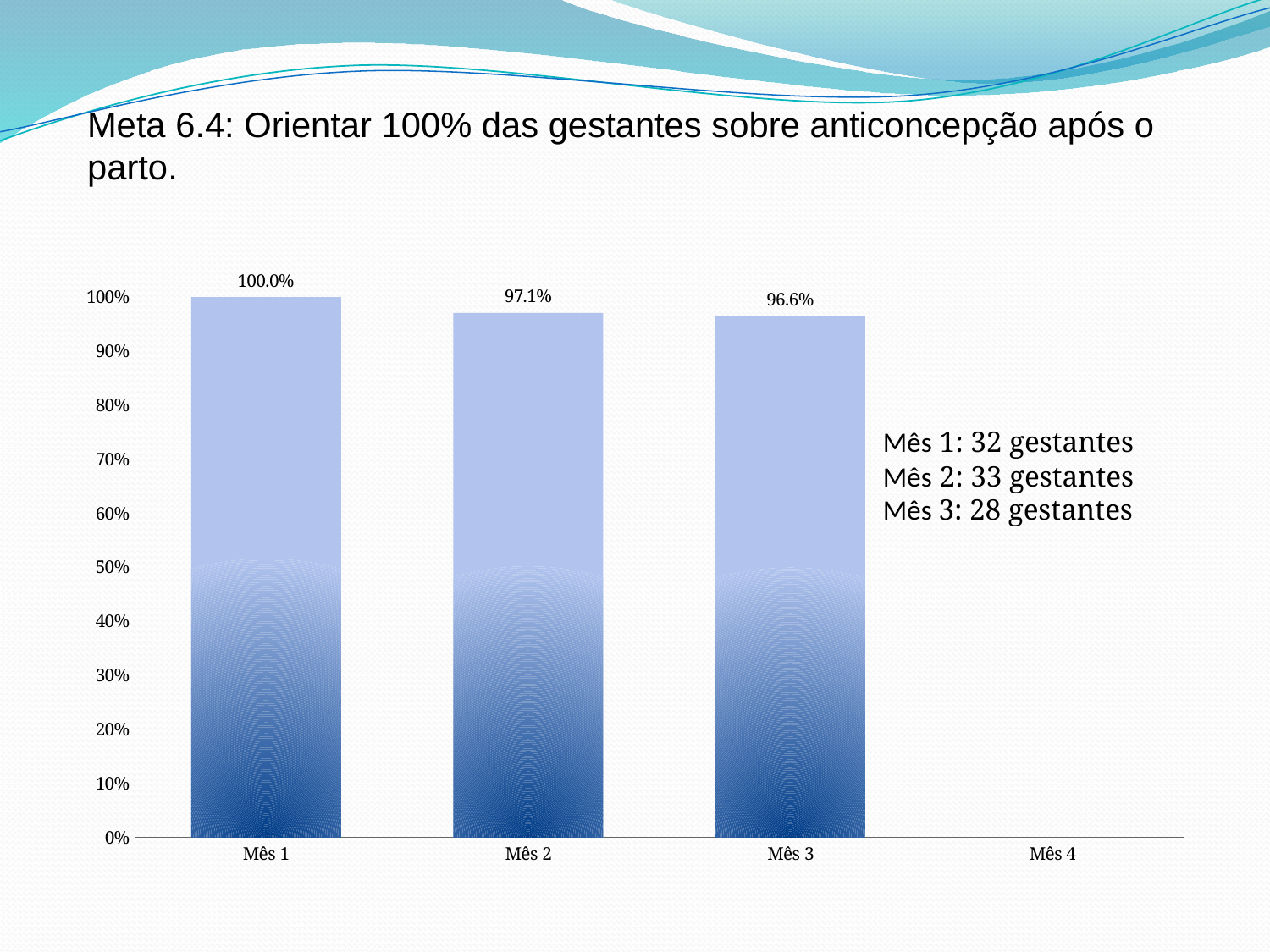
What is the value for Mês 3? 96.6% Do the values rise or fall from Mês 1 to Mês 3? fall Which is larger, the value for Mês 1 or the value for Mês 3? Mês 1 How many categories are shown on the x axis? 4 What is the value for Mês 1? 100.0% What is the value for Mês 2? 97.1% What is the difference between the values for Mês 1 and Mês 2? 2.9% What is the difference between the values for Mês 2 and Mês 3? 0.5% Among the months with a plotted bar, which has the lowest value? Mês 3 Is the value for Mês 3 greater or less than 90%? greater What kind of chart is shown on the slide? bar chart Which month has the highest value? Mês 1